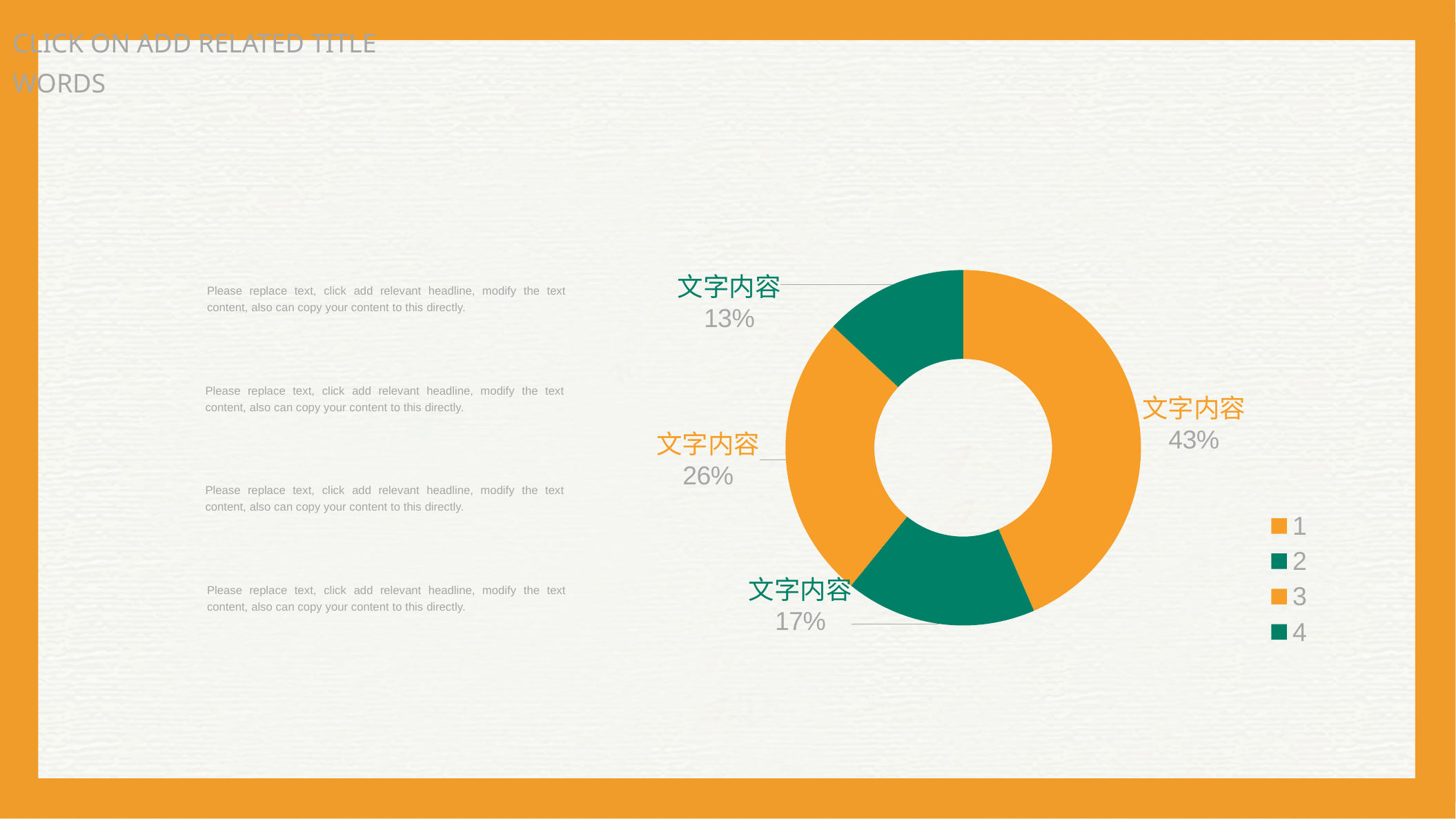
Which is larger in the doughnut chart: the slice for legend category 2 or the slice for legend category 3? 3 What percentage is shown for legend category 2 in the doughnut chart? 17% What colour are the slices for legend categories 2 and 4 in the doughnut chart? Green How many entries does the chart's legend list? 4 How many slices does the doughnut chart have? 4 Which legend category has the largest slice in the doughnut chart? 1 What is the difference in percentage points between the largest slice (43%) and the smallest slice (13%)? 30 What percentage is shown for legend category 3 in the doughnut chart? 26% What percentage is shown for legend category 1 in the doughnut chart? 43% Which legend category has the smallest slice in the doughnut chart? 4 What type of chart is shown on the slide? Doughnut chart What percentage is shown for legend category 4 in the doughnut chart? 13%